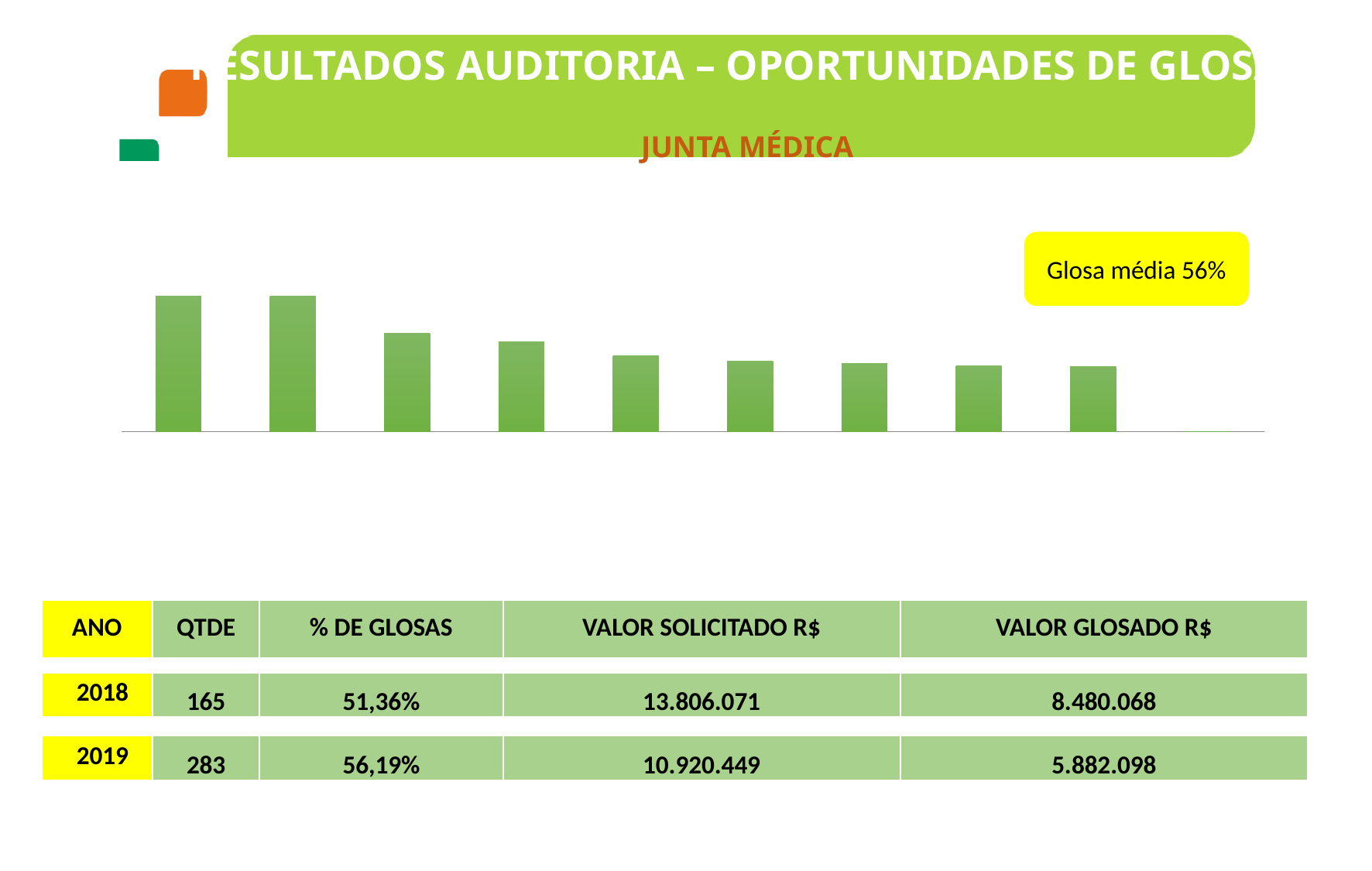
What kind of chart is shown on the slide? bar chart What value does the yellow callout box next to the chart state for 'Glosa média'? 56% How many bars does the chart contain? 9 Is the first bar on the left taller or shorter than the last bar on the right? taller What colour are the bars in the chart? green Do the bar values generally rise or fall from left to right across the chart? fall Is the third bar from the left taller or shorter than the fifth bar from the left? taller